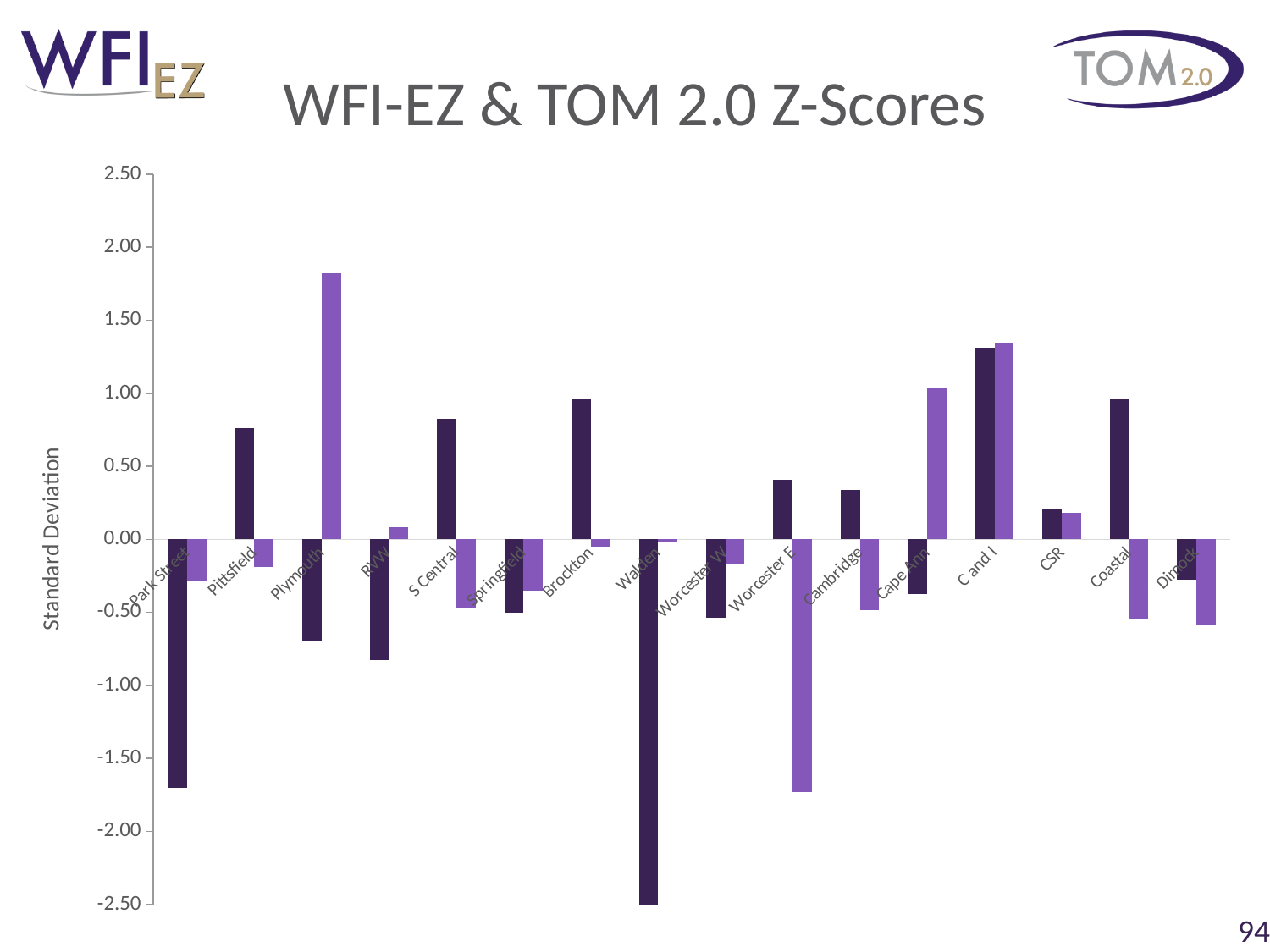
Which category has the lowest light purple bar? Worcester E Is the dark purple bar for Park Street greater or less than -1.50? less What kind of chart is shown on the slide? bar chart Which is larger, the dark purple bar for Pittsfield or the dark purple bar for Park Street? Pittsfield Which category has the lowest bar in the chart? Walden Is the light purple bar for Worcester E greater or less than -1.50? less What is the label on the vertical axis of the chart? Standard Deviation How many categories are shown along the x axis of the chart? 16 Is the light purple bar for Plymouth greater or less than 1.50? greater What is the title of the chart? WFI-EZ & TOM 2.0 Z-Scores Which category has the highest bar in the chart? Plymouth